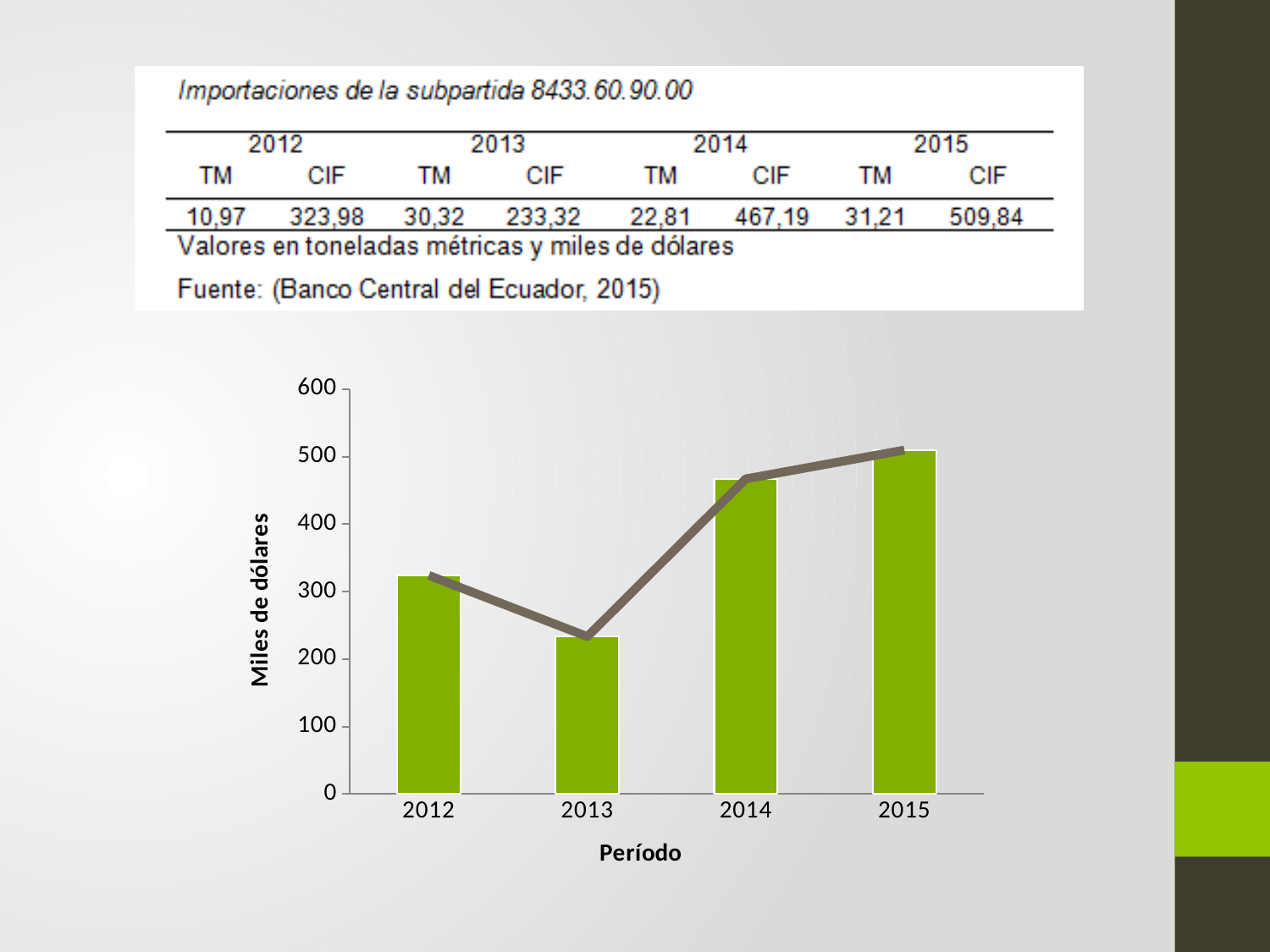
What is the label of the x axis of the chart? Período Which period has the lowest bar in the chart? 2013 What is the label of the y axis of the chart? Miles de dólares How many periods (bars) are plotted on the x axis of the chart? 4 What kind of chart is shown on the slide? bar chart with a line Which is larger, the value for 2012 or the value for 2014? 2014 Which period has the highest bar in the chart? 2015 Is the value for 2015 greater or less than 500? greater According to the table on the slide, what is the CIF value for 2015 that is plotted in the chart? 509,84 Is the value for 2013 greater or less than 300? less Do the values rise or fall from 2013 to 2015? rise Is the value for 2014 greater or less than 400? greater